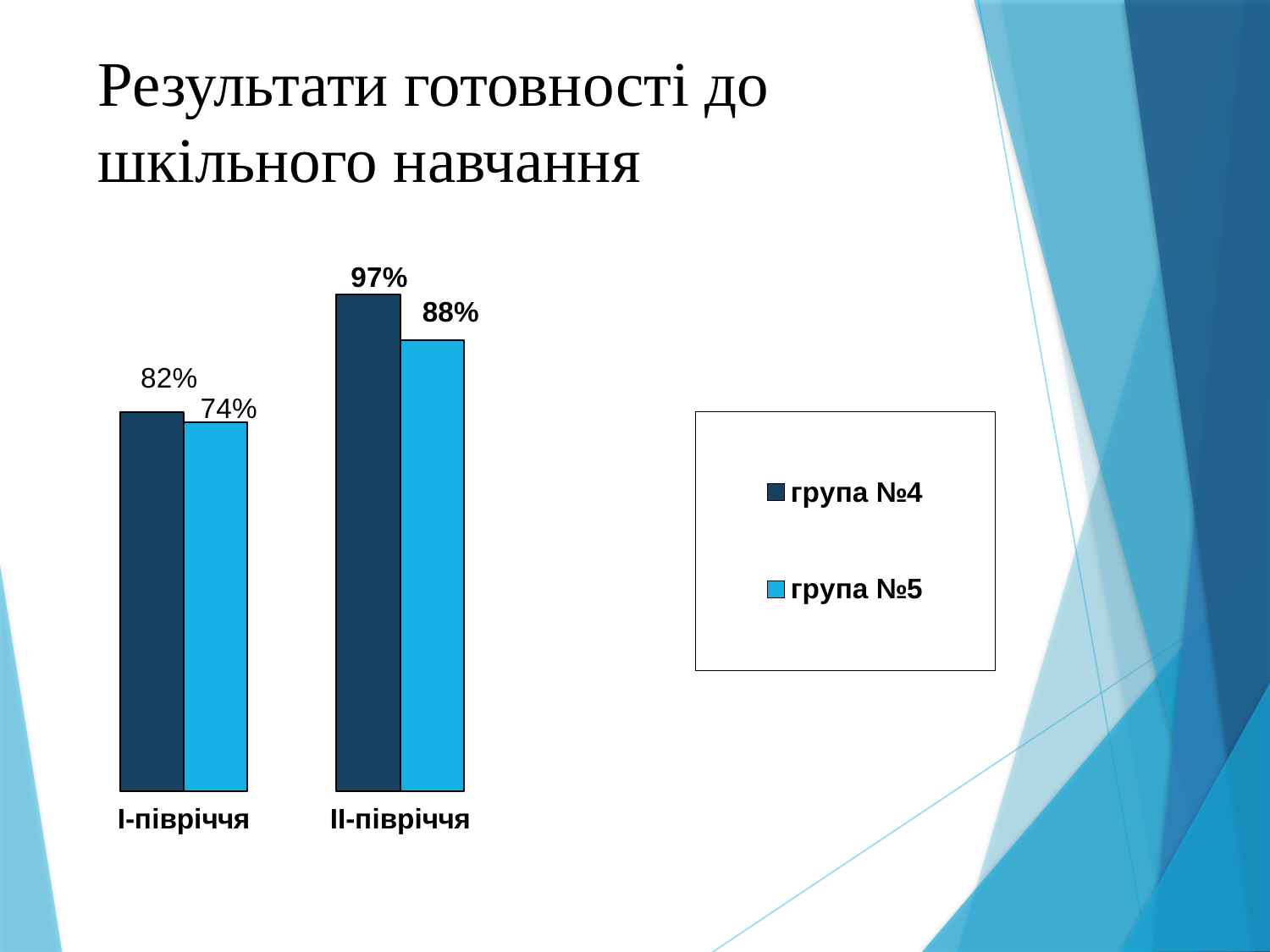
What is the difference between група №4 in ІІ-півріччя and група №4 in І-півріччя? 15% What is the value for група №5 in ІІ-півріччя? 88% Which bar has the highest value on the chart? група №4 in ІІ-півріччя What is the value for група №4 in ІІ-півріччя? 97% How many categories are shown on the x axis? 2 Which bar has the lowest value on the chart? група №5 in І-півріччя What kind of chart is shown on the slide? bar chart How many series does the legend list? 2 What is the difference between група №4 and група №5 in ІІ-півріччя? 9% What is the value for група №4 in І-півріччя? 82% What is the value for група №5 in І-півріччя? 74% Which is larger in І-півріччя: група №4 or група №5? група №4